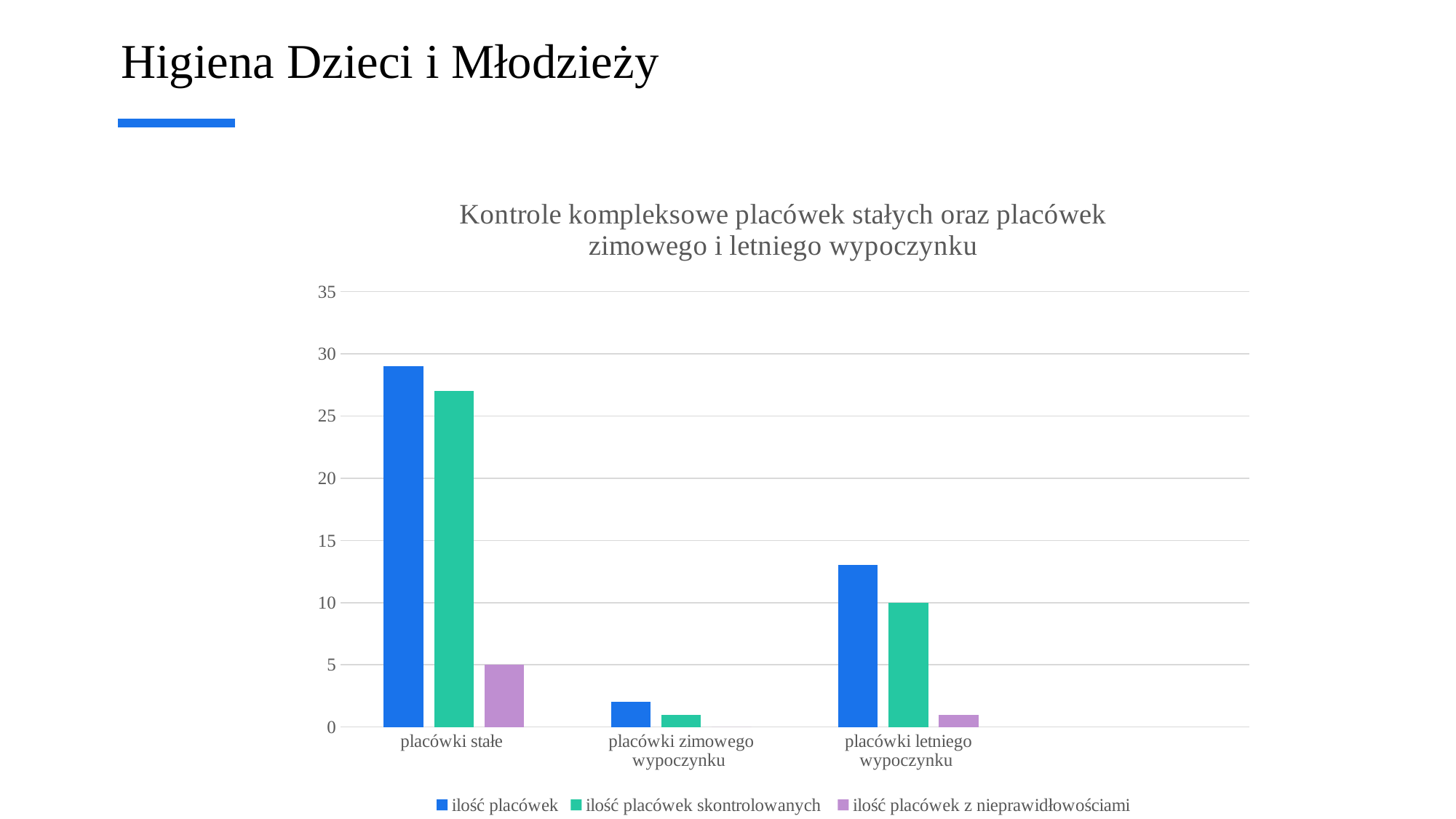
What is the value of 'ilość placówek z nieprawidłowościami' for 'placówki stałe'? 5 Which category has the lowest value for 'ilość placówek skontrolowanych'? placówki zimowego wypoczynku Which category has the highest value for 'ilość placówek'? placówki stałe Is the value of 'ilość placówek' for 'placówki letniego wypoczynku' greater or less than 15? less How many series does the legend list? 3 Is the value of 'ilość placówek' for 'placówki zimowego wypoczynku' greater or less than 5? less How many categories are shown on the x axis? 3 Which is larger for 'placówki stałe': 'ilość placówek' or 'ilość placówek skontrolowanych'? ilość placówek What is the title of the chart? Kontrole kompleksowe placówek stałych oraz placówek zimowego i letniego wypoczynku Is the value of 'ilość placówek' for 'placówki stałe' greater or less than 25? greater What kind of chart is shown on the slide? bar chart What is the value of 'ilość placówek skontrolowanych' for 'placówki letniego wypoczynku'? 10